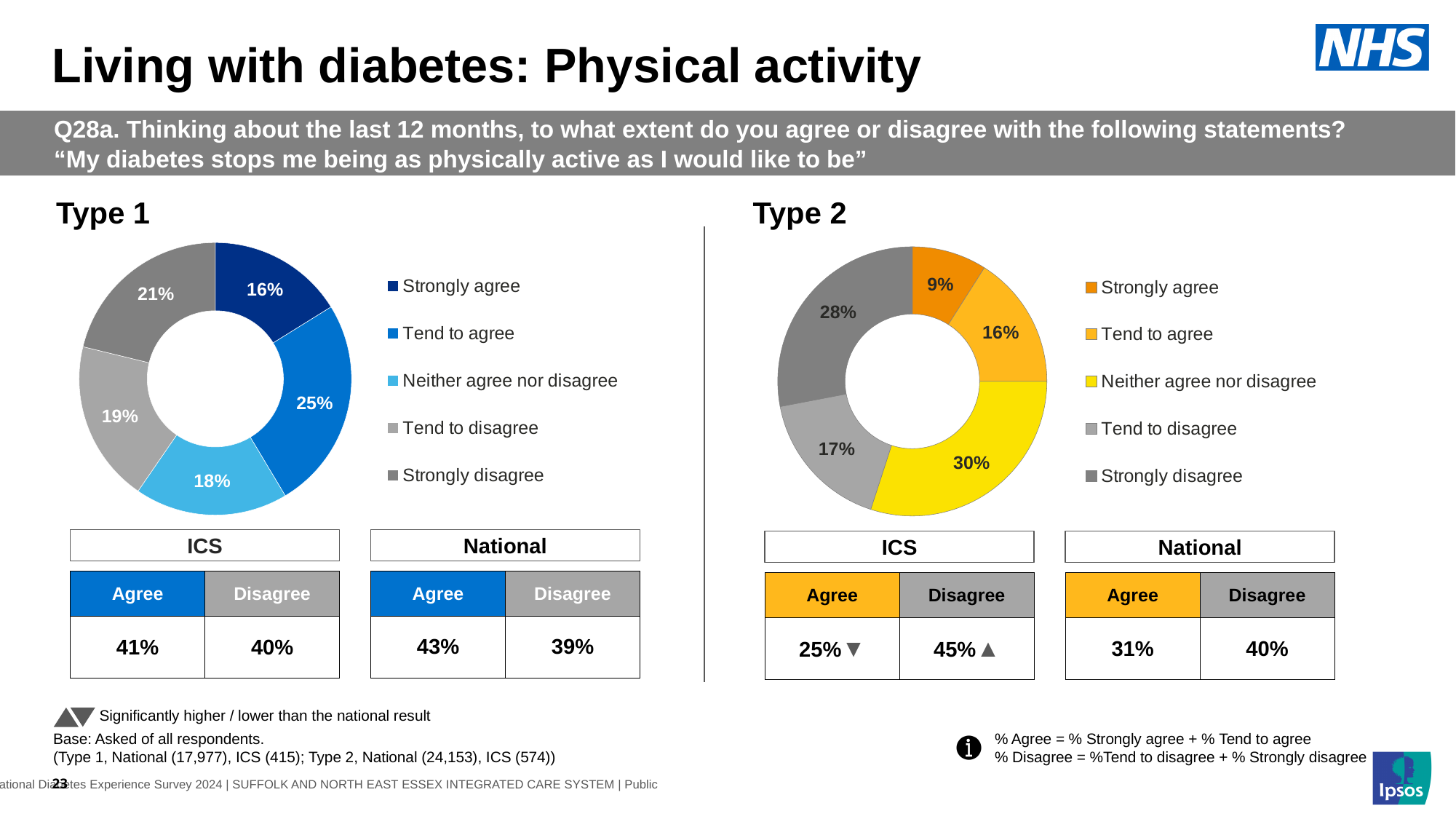
In the Type 1 chart, what percentage of respondents said 'Tend to agree'? 25% In the Type 1 chart, which category has the smallest share? Strongly agree In the Type 1 chart, what is the difference between the 'Tend to agree' and 'Strongly agree' shares? 9 percentage points In the Type 2 chart, what percentage of respondents said 'Strongly agree'? 9% In the Type 2 chart, what percentage of respondents said 'Neither agree nor disagree'? 30% In the Type 1 chart, which is larger: 'Tend to disagree' or 'Neither agree nor disagree'? Tend to disagree In the Type 2 chart, what is the difference between the 'Strongly disagree' and 'Tend to disagree' shares? 11 percentage points In the Type 2 chart, which category has the largest share? Neither agree nor disagree What kind of chart is used for Type 1? Doughnut (pie) chart In the Type 1 chart, what percentage of respondents said 'Strongly disagree'? 21% In the Type 2 chart, which category has the smallest share? Strongly agree How many categories does the legend of the Type 2 chart list? 5